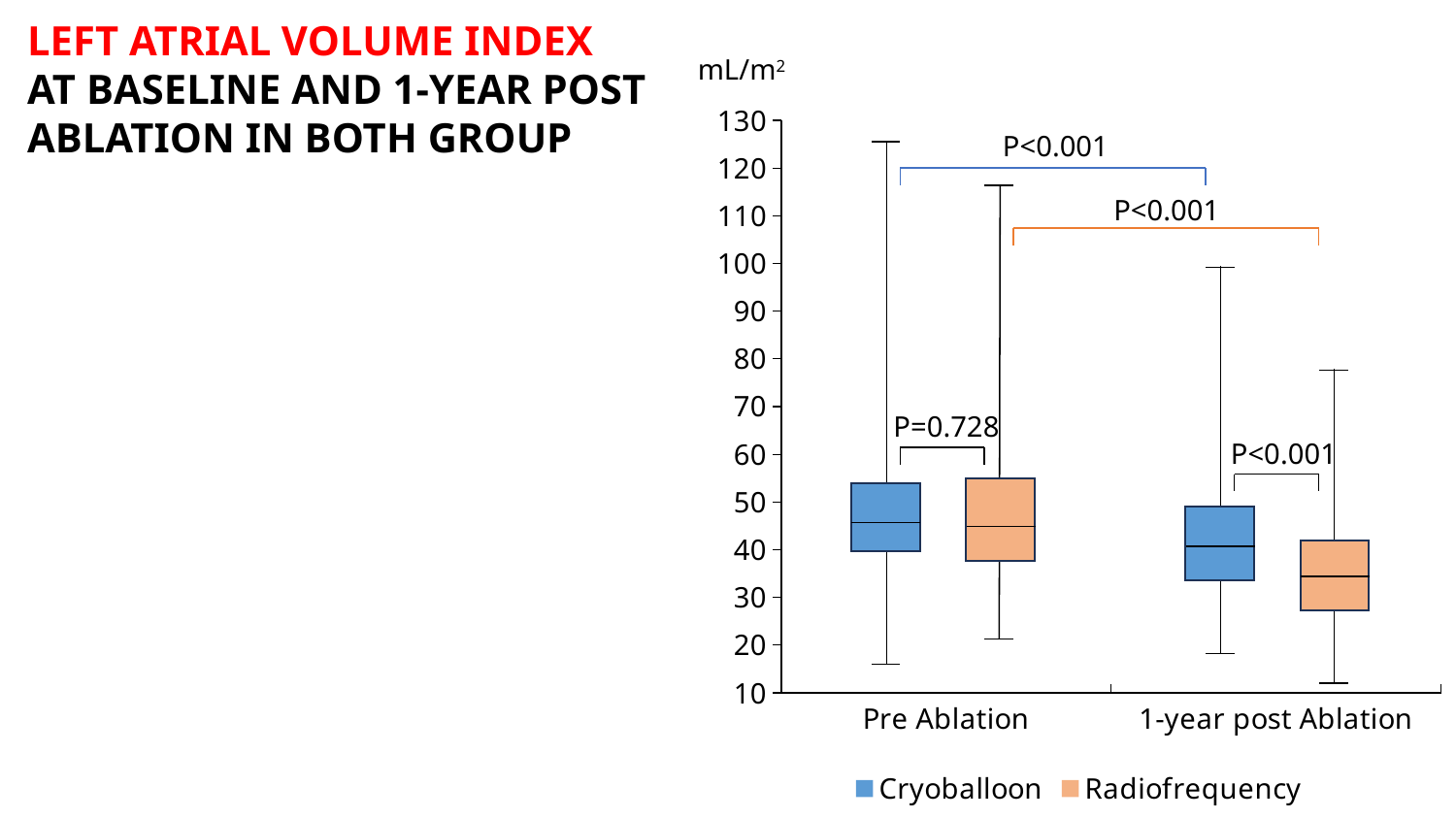
What unit is shown on the y axis? mL/m² How many series does the legend list? 2 Which two series are listed in the legend? Cryoballoon and Radiofrequency Is the median value for Radiofrequency at 1-year post Ablation greater or less than 40? less At 1-year post Ablation, which group has the higher median: Cryoballoon or Radiofrequency? Cryoballoon What P-value is shown for the comparison between Cryoballoon and Radiofrequency at Pre Ablation? P=0.728 What P-value is shown for the comparison between Cryoballoon and Radiofrequency at 1-year post Ablation? P<0.001 Is the median value for Cryoballoon at Pre Ablation greater or less than 40? greater What P-value is shown for the change in the Cryoballoon group from Pre Ablation to 1-year post Ablation? P<0.001 What kind of chart is shown on the slide? Box-and-whisker plot How many categories are shown on the x axis? 2 Is the top of the upper whisker for Cryoballoon at Pre Ablation greater or less than 120? greater